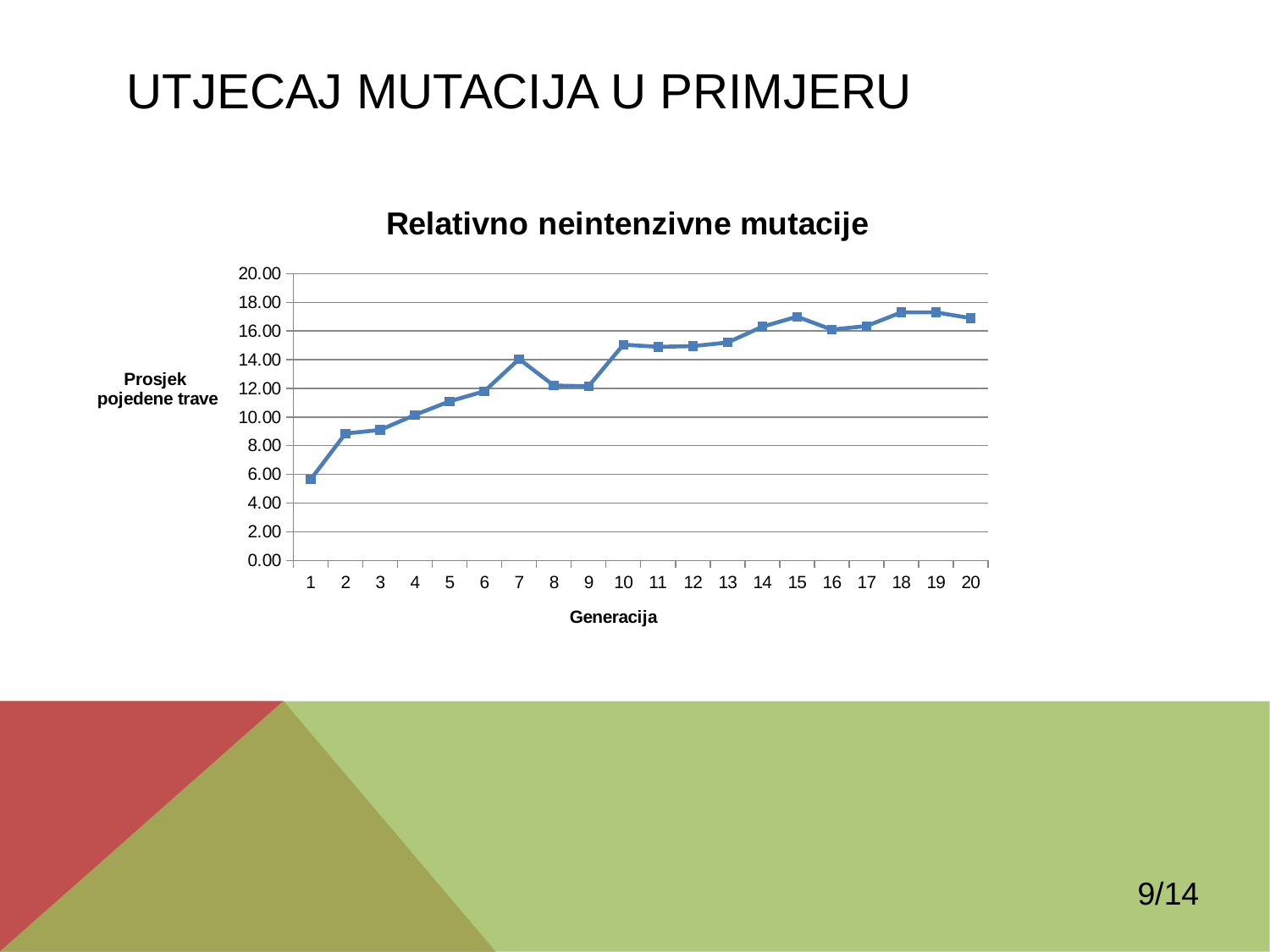
Which generation has the lowest average grass eaten? 1 What is the title of the chart? Relativno neintenzivne mutacije What is the label of the x axis? Generacija Which has the larger value, generation 7 or generation 8? generation 7 Is the value for generation 15 greater or less than 16.00? greater What kind of chart is shown on the slide? line chart Is the value for generation 1 greater or less than 8.00? less Which has the larger value, generation 6 or generation 10? generation 10 How many generations are plotted along the x axis? 20 Is the value for generation 3 greater or less than 10.00? less Do the values generally rise or fall as the generation number increases? rise